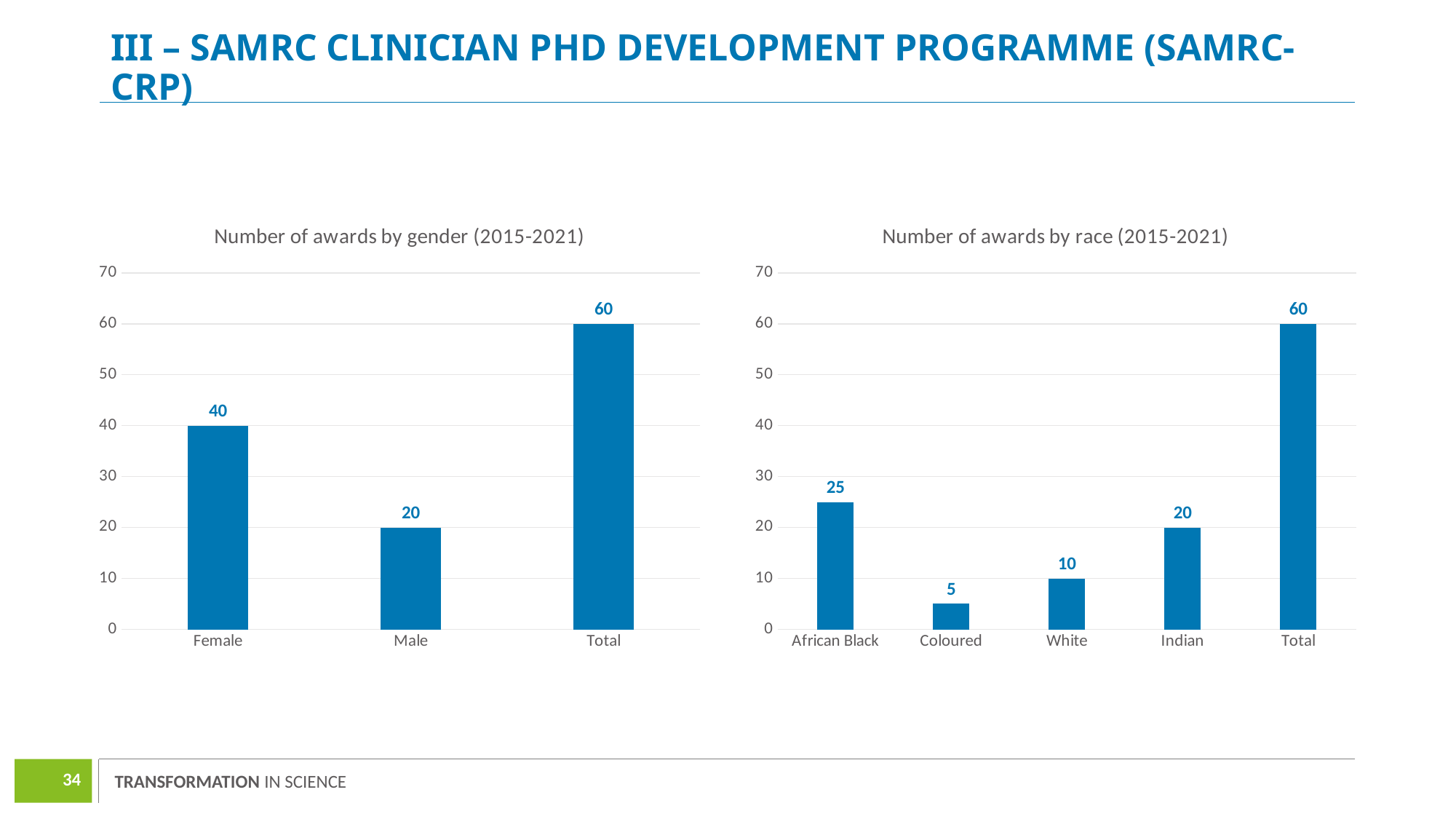
In the 'Number of awards by gender (2015-2021)' chart, what is the difference between the Female and Male values? 20 In the 'Number of awards by gender (2015-2021)' chart, what is the value for Female? 40 In the 'Number of awards by race (2015-2021)' chart, excluding Total, which category has the highest value? African Black In the 'Number of awards by gender (2015-2021)' chart, what is the value for Male? 20 In the 'Number of awards by race (2015-2021)' chart, what is the difference between the Indian and White values? 10 In the 'Number of awards by race (2015-2021)' chart, which category has the lowest value? Coloured In the 'Number of awards by race (2015-2021)' chart, what is the value for African Black? 25 How many categories are shown in the 'Number of awards by race (2015-2021)' chart? 5 What is the title of the chart on the right side of the slide? Number of awards by race (2015-2021) In the 'Number of awards by gender (2015-2021)' chart, which is larger, Female or Male? Female What type of chart is the 'Number of awards by gender (2015-2021)' chart? Bar chart In the 'Number of awards by race (2015-2021)' chart, what is the value for Coloured? 5